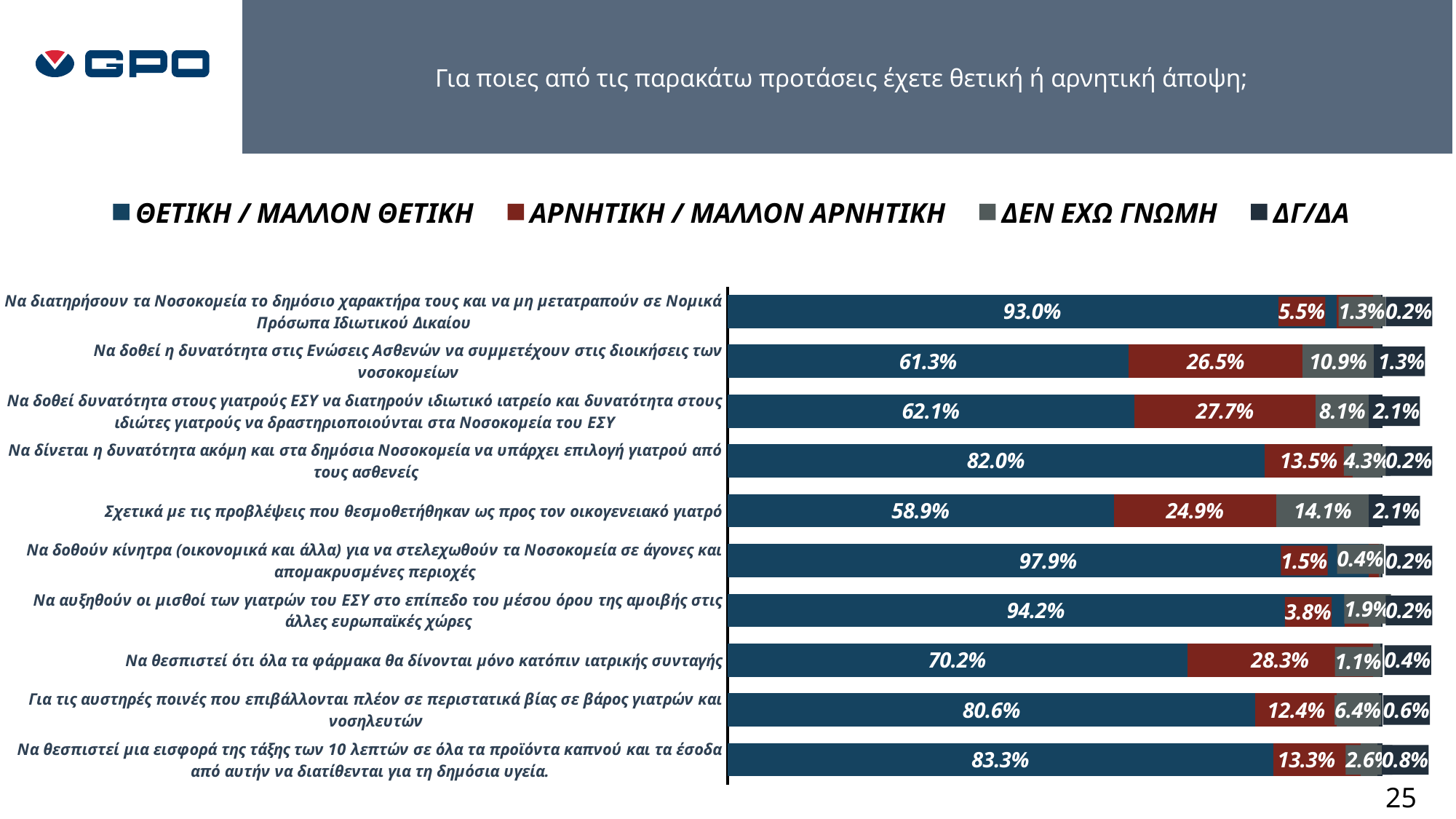
Which statement has the lowest ΘΕΤΙΚΗ / ΜΑΛΛΟΝ ΘΕΤΙΚΗ value? Σχετικά με τις προβλέψεις που θεσμοθετήθηκαν ως προς τον οικογενειακό γιατρό What is the ΔΓ/ΔΑ value for the statement about strict penalties for violence against doctors and nurses (Για τις αυστηρές ποινές...)? 0.6% What is the ΔΕΝ ΕΧΩ ΓΝΩΜΗ value for the statement about the family doctor provisions (Σχετικά με τις προβλέψεις... οικογενειακό γιατρό)? 14.1% How many series does the legend list? 4 What is the ΑΡΝΗΤΙΚΗ / ΜΑΛΛΟΝ ΑΡΝΗΤΙΚΗ value for the statement that all medicines be given only by prescription (Να θεσπιστεί ότι όλα τα φάρμακα...)? 28.3% What colour represents the ΑΡΝΗΤΙΚΗ / ΜΑΛΛΟΝ ΑΡΝΗΤΙΚΗ series in the chart? Dark red What is the difference between the ΘΕΤΙΚΗ / ΜΑΛΛΟΝ ΘΕΤΙΚΗ values for the statement on raising ΕΣΥ doctors' salaries (94.2%) and the statement on patient associations in hospital administrations (61.3%)? 32.9 percentage points What is the ΘΕΤΙΚΗ / ΜΑΛΛΟΝ ΘΕΤΙΚΗ value for the statement about incentives to staff hospitals in remote areas (Να δοθούν κίνητρα...)? 97.9% What kind of chart is shown on the slide? Stacked horizontal bar chart Which statement has the highest ΘΕΤΙΚΗ / ΜΑΛΛΟΝ ΘΕΤΙΚΗ value? Να δοθούν κίνητρα (οικονομικά και άλλα) για να στελεχωθούν τα Νοσοκομεία σε άγονες και απομακρυσμένες περιοχές Which has a larger ΑΡΝΗΤΙΚΗ / ΜΑΛΛΟΝ ΑΡΝΗΤΙΚΗ value: the statement on ΕΣΥ doctors keeping private practices or the statement on patient associations in hospital administrations? The statement on ΕΣΥ doctors keeping private practices (27.7%) How many statements (categories) are plotted in the chart? 10